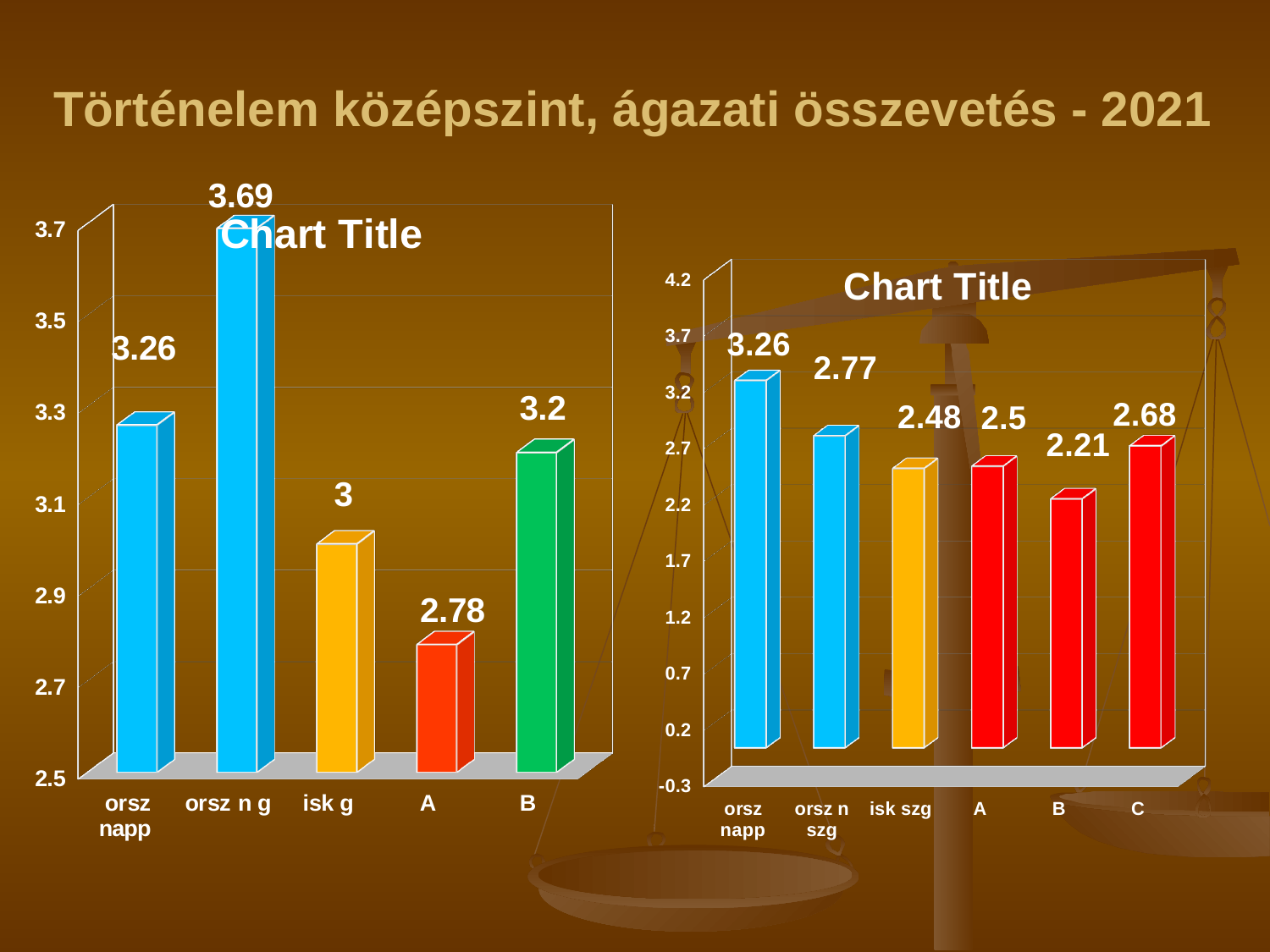
How many categories are shown in the left chart? 5 What kind of chart is the right chart? bar chart In the right chart, what is the value for isk szg? 2.48 How many categories are shown in the right chart? 6 In the right chart, what is the value for C? 2.68 In the left chart, which category has the highest value? orsz n g In the left chart, what is the value for orsz n g? 3.69 In the right chart, which category has the lowest value? B In the left chart, what is the difference between the values for orsz n g and isk g? 0.69 In the left chart, what is the value for A? 2.78 In the right chart, which is larger, the value for orsz n szg or the value for A? orsz n szg In the left chart, which category has the lowest value? A